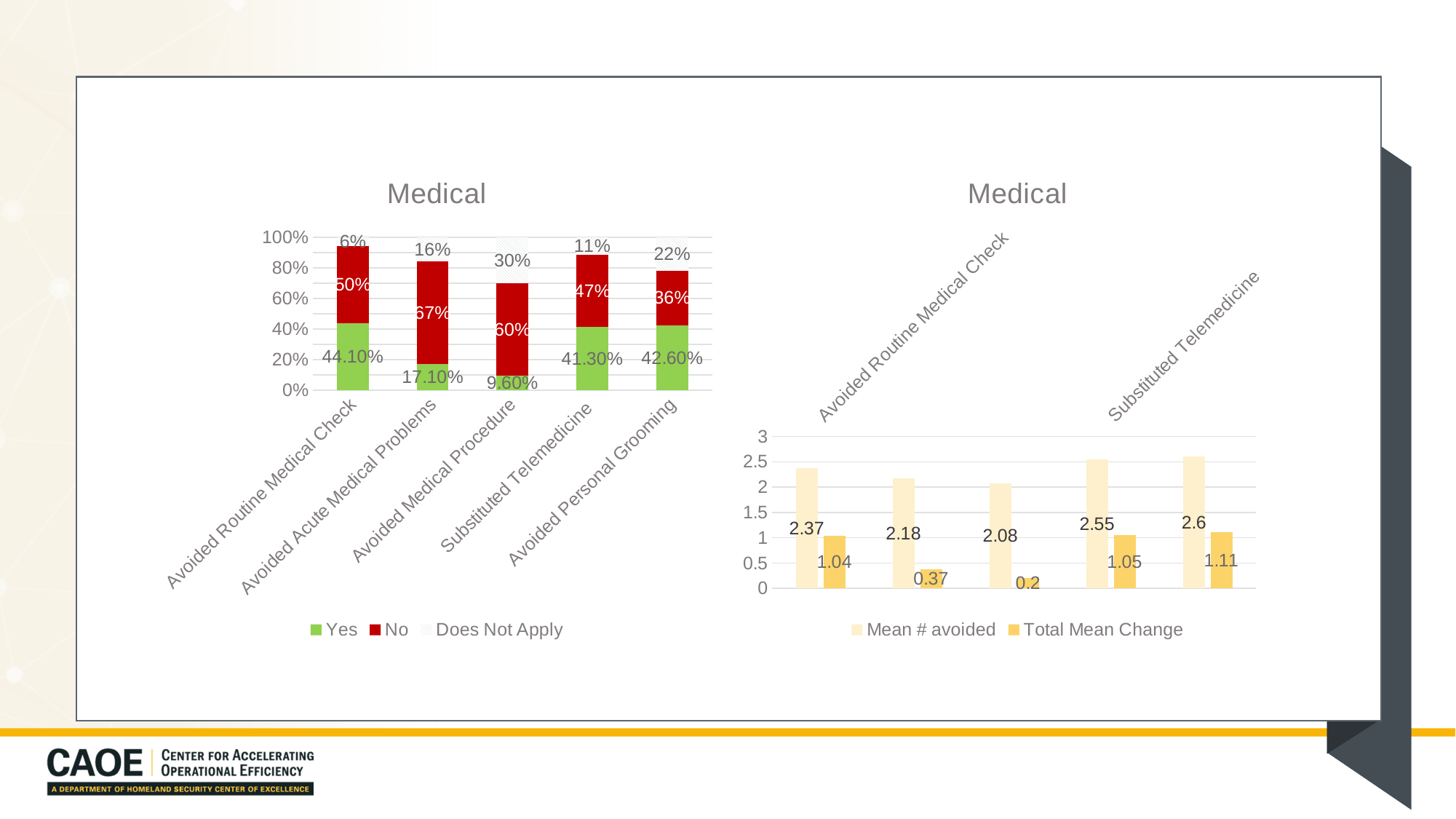
In the left chart, what is the difference between the Yes values for Avoided Personal Grooming and Substituted Telemedicine? 1.30% In the left chart, what is the Yes value for Avoided Routine Medical Check? 44.10% In the right chart, what is the Total Mean Change value for Substituted Telemedicine? 1.05 In the left chart, how many series does the legend list? 3 What kind of chart is the left chart? Stacked bar chart In the left chart, which category has the lowest Yes value? Avoided Medical Procedure In the right chart, what is the Mean # avoided value for Avoided Routine Medical Check? 2.37 In the left chart, what is the No value for Avoided Acute Medical Problems? 67% In the left chart, which category has the highest No value? Avoided Acute Medical Problems In the left chart, what is the Does Not Apply value for Avoided Medical Procedure? 30% In the right chart, what is the highest Mean # avoided value shown? 2.6 In the right chart, what is the lowest Total Mean Change value shown? 0.2